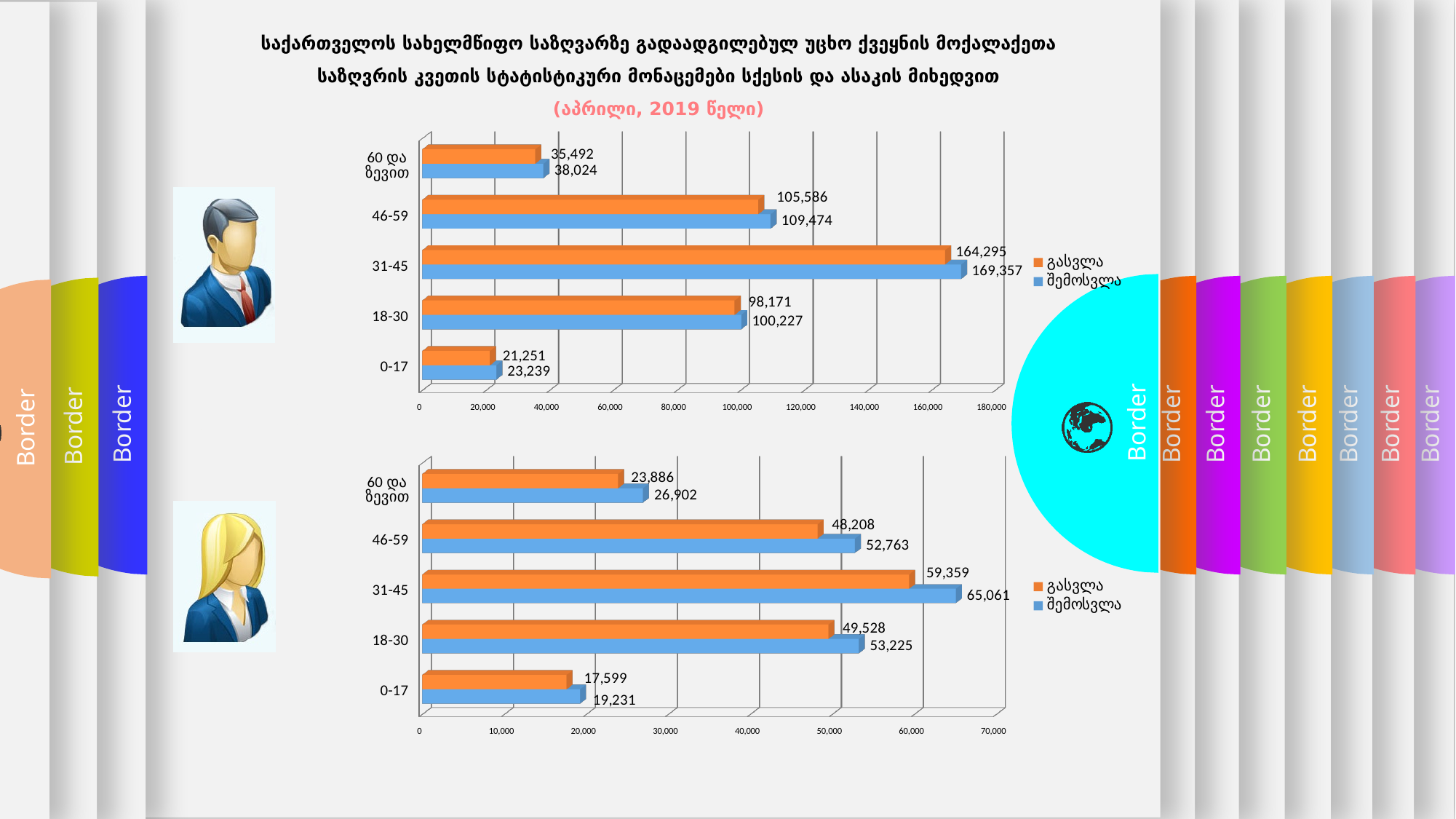
In the bottom chart, what is the შემოსვლა value for the 46-59 age group? 52,763 In the top chart, what is the difference between the შემოსვლა and გასვლა values for the 46-59 age group? 3,888 In the bottom chart, what is the difference between the შემოსვლა and გასვლა values for the 31-45 age group? 5,702 In the top chart, what is the გასვლა value for the 31-45 age group? 164,295 How many series does the legend of the bottom chart list? 2 What type of chart is the top chart? Bar chart In the top chart, which age group has the highest შემოსვლა value? 31-45 In the bottom chart, what is the გასვლა value for the 18-30 age group? 49,528 In the bottom chart, which is larger for the 60 და ზევით age group: გასვლა or შემოსვლა? შემოსვლა In the bottom chart, which age group has the lowest გასვლა value? 0-17 How many age groups are shown in the top chart? 5 In the top chart, what is the შემოსვლა value for the 0-17 age group? 23,239